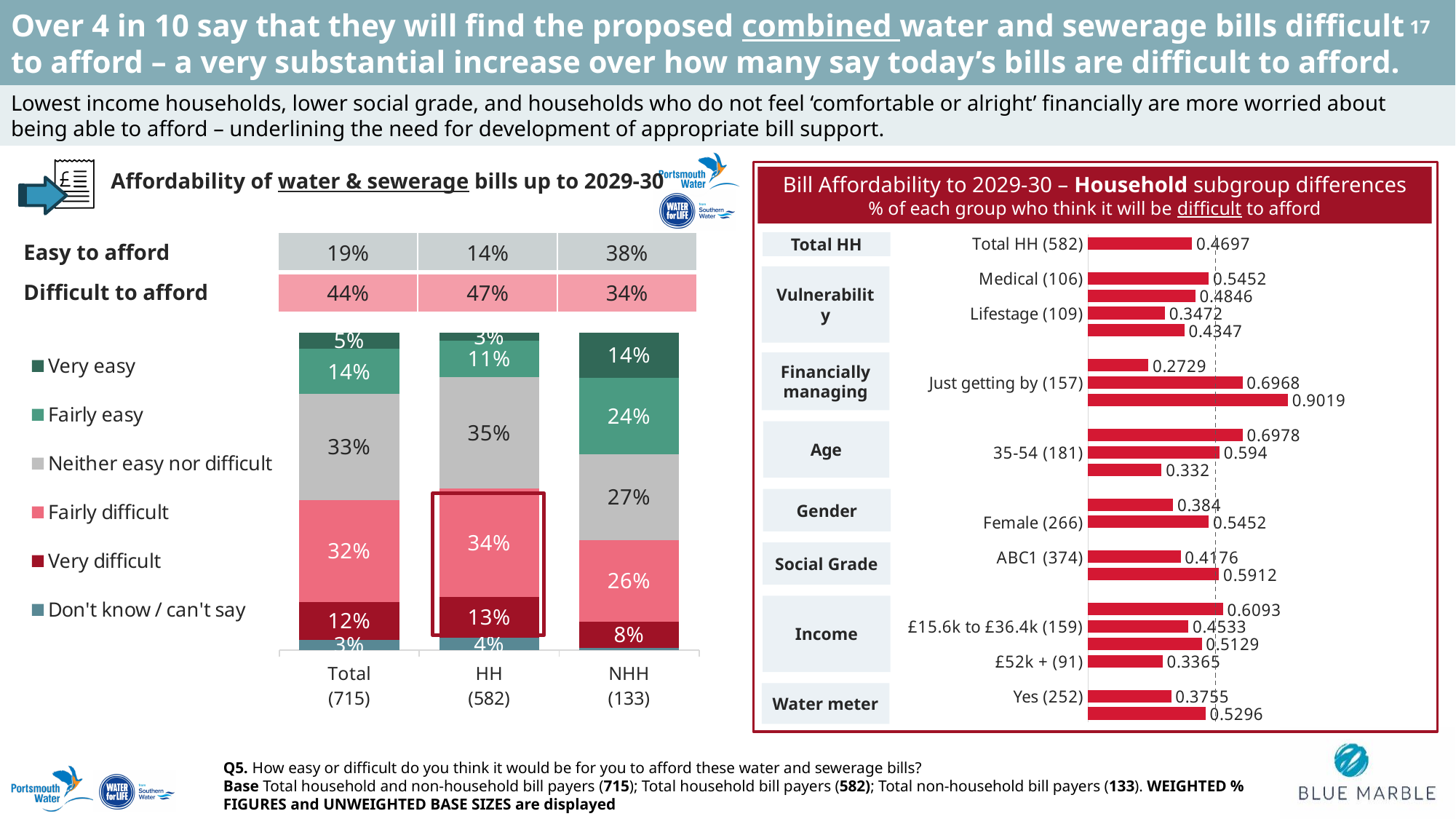
In the 'Household subgroup differences' chart, what is the value for Just getting by (157)? 0.6968 How many series does the legend of the stacked bar chart on the left list? 6 In the stacked bar chart on the left, what percentage of HH (582) respondents said 'Fairly difficult'? 34% In the 'Household subgroup differences' chart, which is larger: the value for Female (266) or for ABC1 (374)? Female (266) How many bars (groups) are shown in the stacked bar chart on the left? 3 What type of chart is the 'Bill Affordability to 2029-30 – Household subgroup differences' chart? Bar chart In the left chart, what is the difference between the 'Easy to afford' percentage for NHH and for HH? 24% In the stacked bar chart on the left, what percentage of NHH (133) respondents said 'Very easy'? 14% In the 'Household subgroup differences' chart, what is the value for £52k + (91)? 0.3365 In the left chart, which is larger: the 'Very difficult' share for HH or for NHH? HH In the left chart, which group has the highest 'Difficult to afford' percentage: Total, HH or NHH? HH In the stacked bar chart on the left, what percentage of Total (715) respondents said 'Neither easy nor difficult'? 33%